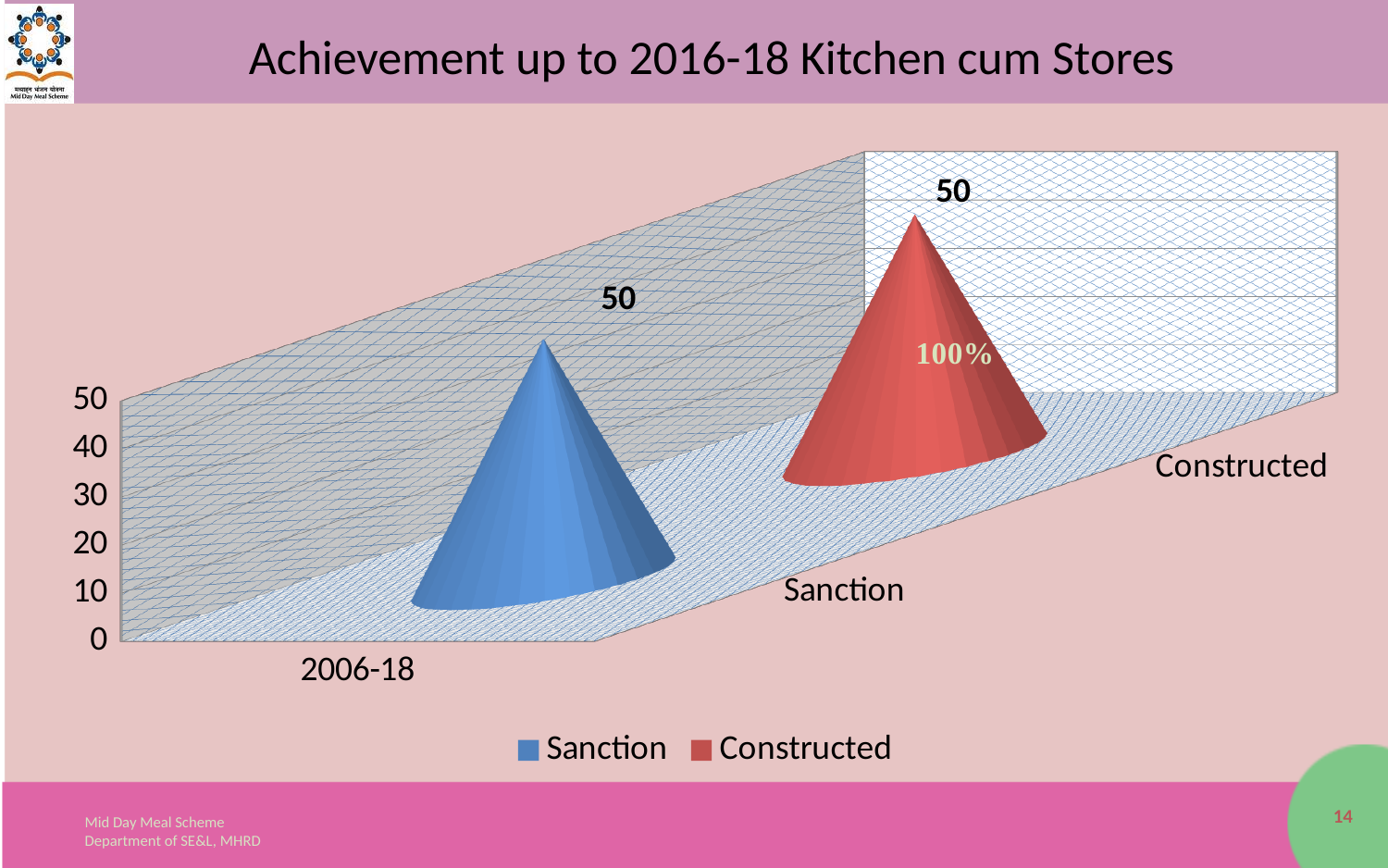
How many series does the legend list? 2 What is the highest value shown on the vertical axis? 50 What is the value of the Sanction series for 2006-18? 50 What kind of chart is shown on the slide? 3D bar chart (cone shaped) Is the value for Sanction in 2006-18 greater or less than 40? greater What is the difference between the Sanction and Constructed values for 2006-18? 0 What percentage label is shown on the Constructed cone? 100% Which series is shown in red? Constructed What is the title of the chart? Achievement up to 2016-18 Kitchen cum Stores What category label is shown on the x axis? 2006-18 How many categories are shown on the x axis? 1 What is the value of the Constructed series for 2006-18? 50